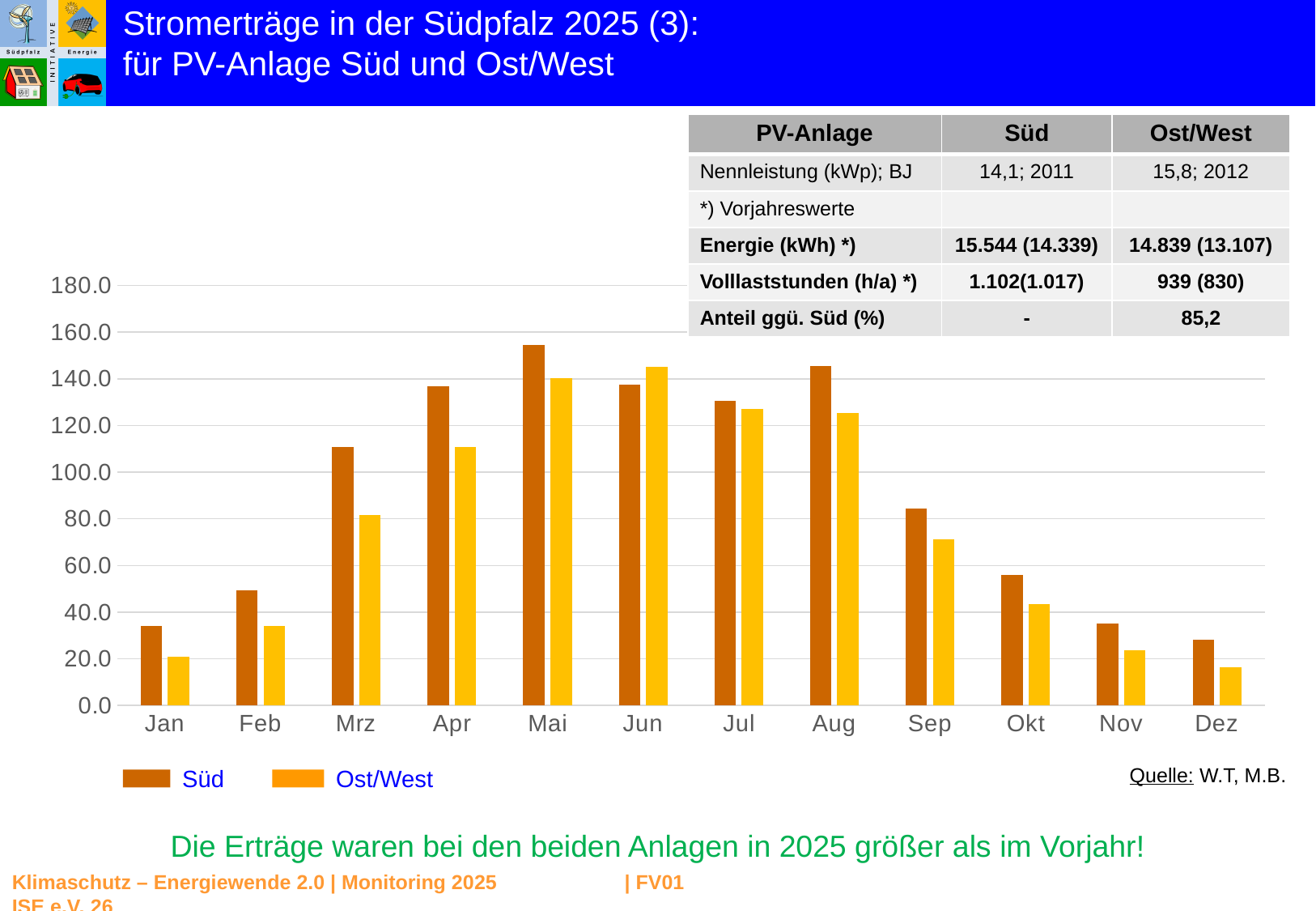
Is the Ost/West value for Okt greater or less than 60? less Is the Süd value for Mrz greater or less than 100? greater In which month is the Ost/West value lowest? Dez How many months are shown on the x axis of the chart? 12 Is the Süd value for Aug greater or less than 120? greater In which month is the Süd value lowest? Dez Do the Süd values rise or fall from Aug to Dez? fall What kind of chart is shown on the slide? bar chart In which month is the Süd value highest? Mai How many series does the chart legend list? 2 In Mrz, which series has the larger value, Süd or Ost/West? Süd